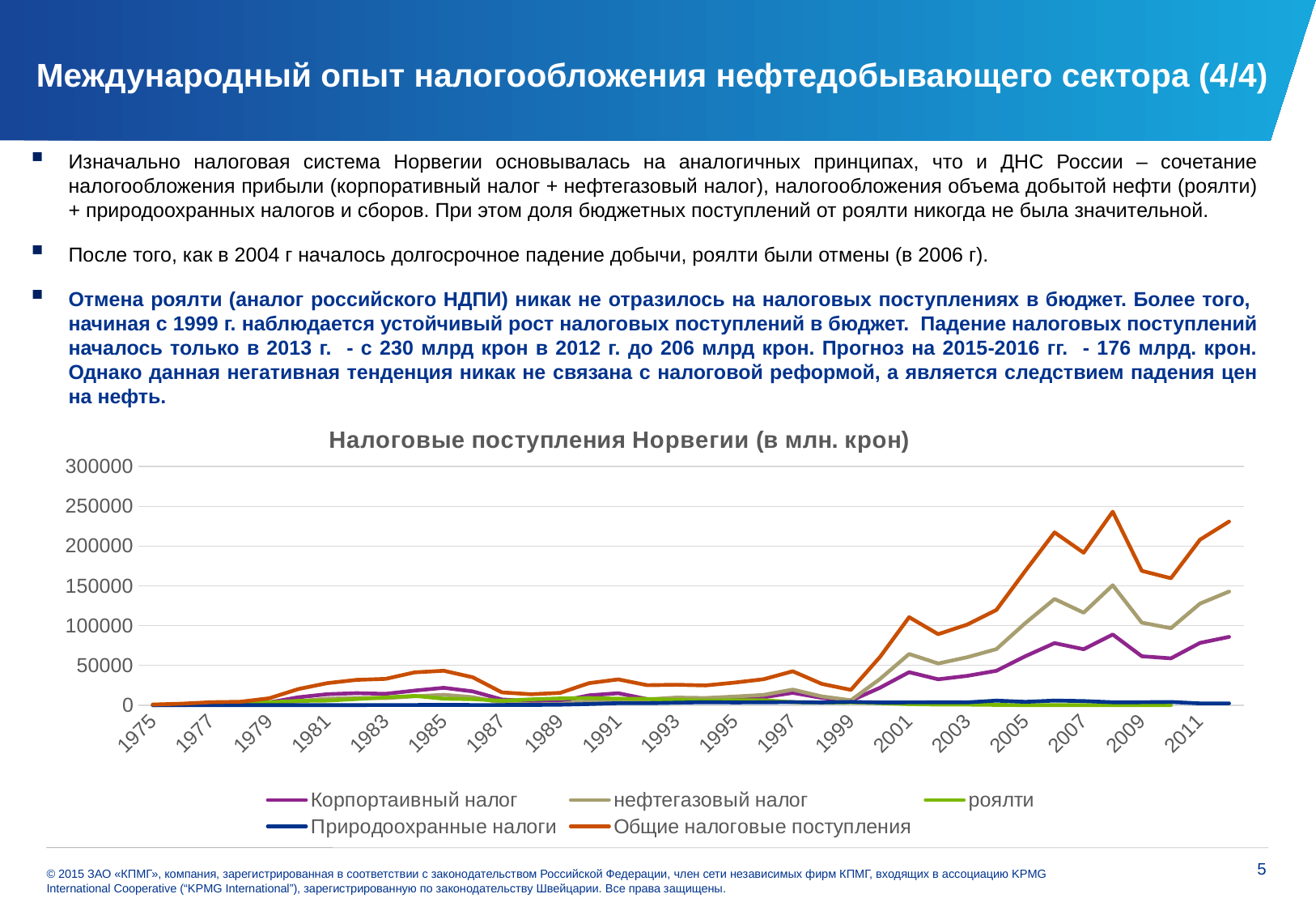
What is the title of the chart? Налоговые поступления Норвегии (в млн. крон) How many series does the chart legend list? 5 In which year does the line for Общие налоговые поступления reach its peak? 2008 Is the value for нефтегазовый налог in 2008 greater or less than 100000? greater Is the value for Общие налоговые поступления in 1999 greater or less than 50000? less Which series is plotted with the orange line? Общие налоговые поступления In 2008, which is larger: нефтегазовый налог or Корпортаивный налог? нефтегазовый налог Is the value for Общие налоговые поступления in 2008 greater or less than 200000? greater Which series reaches the highest value on the chart? Общие налоговые поступления Does the line for Общие налоговые поступления rise or fall between 1999 and 2008? Rise What kind of chart is shown on the slide? Line chart